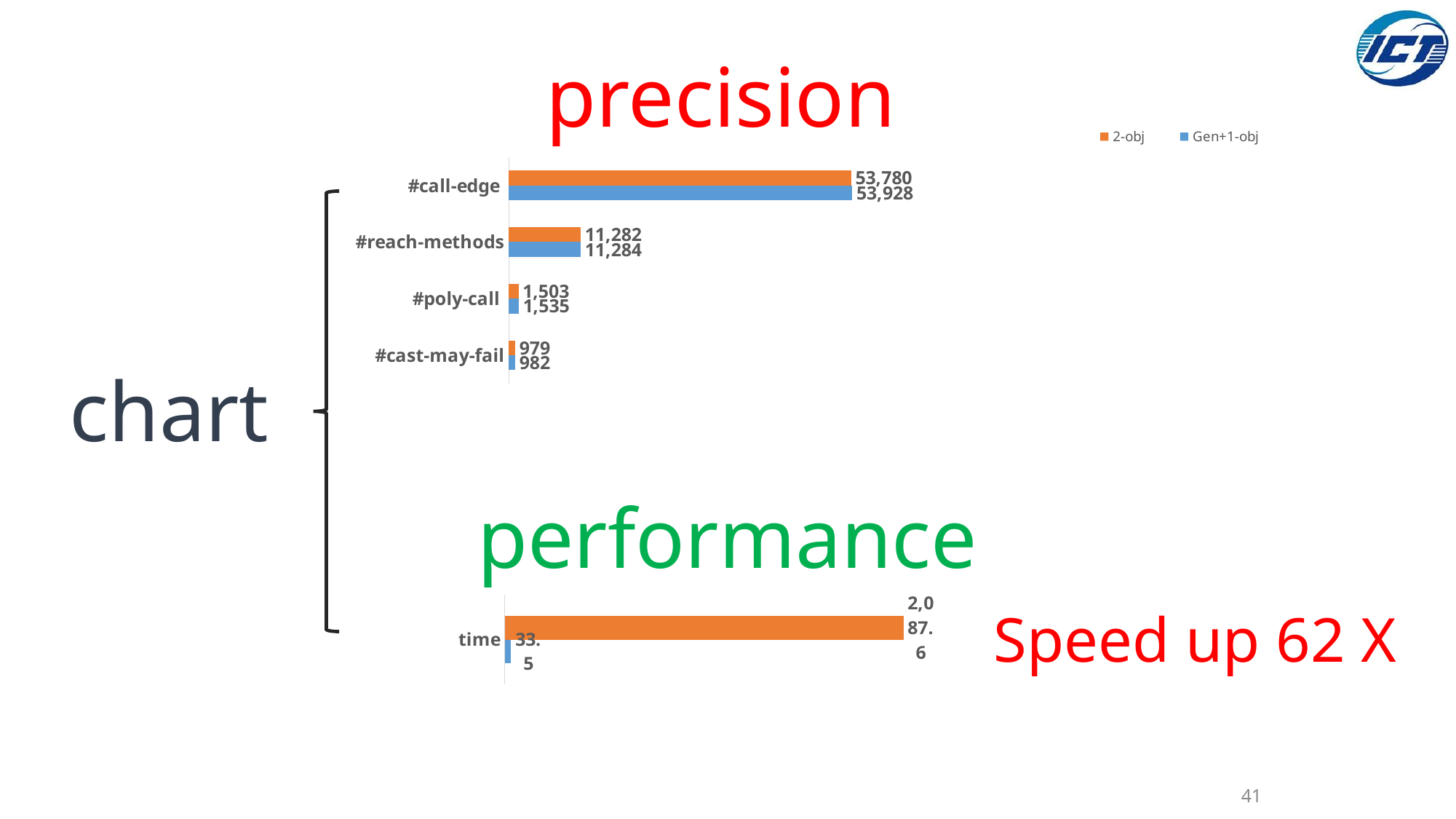
In the precision chart, which category has the lowest values? #cast-may-fail In the precision chart, what is the 2-obj value for #cast-may-fail? 979 In the performance chart, what is the Gen+1-obj value for time? 33.5 In the precision chart, which category has the highest values? #call-edge In the precision chart, what is the Gen+1-obj value for #reach-methods? 11,284 How many series does the legend of the precision chart list? 2 In the performance chart, what is the 2-obj value for time? 2,087.6 How many categories does the precision chart show? 4 In the precision chart, what is the difference between the Gen+1-obj and 2-obj values for #call-edge? 148 In the precision chart, what is the Gen+1-obj value for #poly-call? 1,535 In the precision chart, what is the 2-obj value for #call-edge? 53,780 In the performance chart, which series has the larger value for time, 2-obj or Gen+1-obj? 2-obj